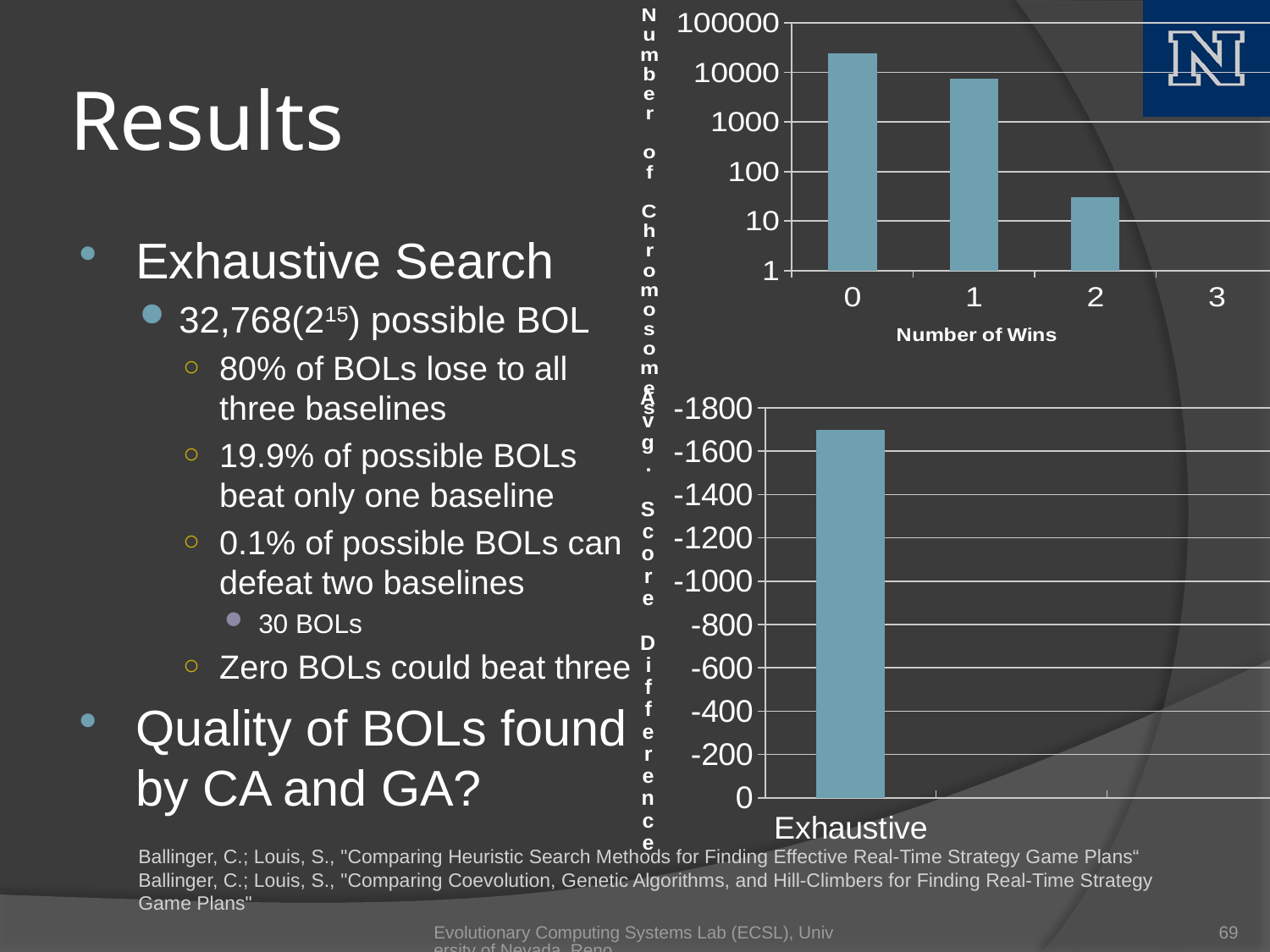
In the top chart, which number of wins has the highest number of chromosomes? 0 In the top chart, is the number of chromosomes for 0 wins greater or less than 10000? greater In the top chart, is the number of chromosomes for 1 win greater or less than 10000? less What kind of chart is the top chart on the slide (Number of Wins)? bar chart In the top chart, how many categories are shown on the Number of Wins axis? 4 In the top chart, do the values rise or fall as the number of wins increases? fall In the bottom chart, is the value for Exhaustive greater or less than -1600? less What is the x-axis title of the top chart? Number of Wins In the bottom chart, how many categories are shown on the x axis? 1 What kind of chart is the bottom chart on the slide (Exhaustive)? bar chart In the top chart, is the bar for 1 win taller or shorter than the bar for 2 wins? taller